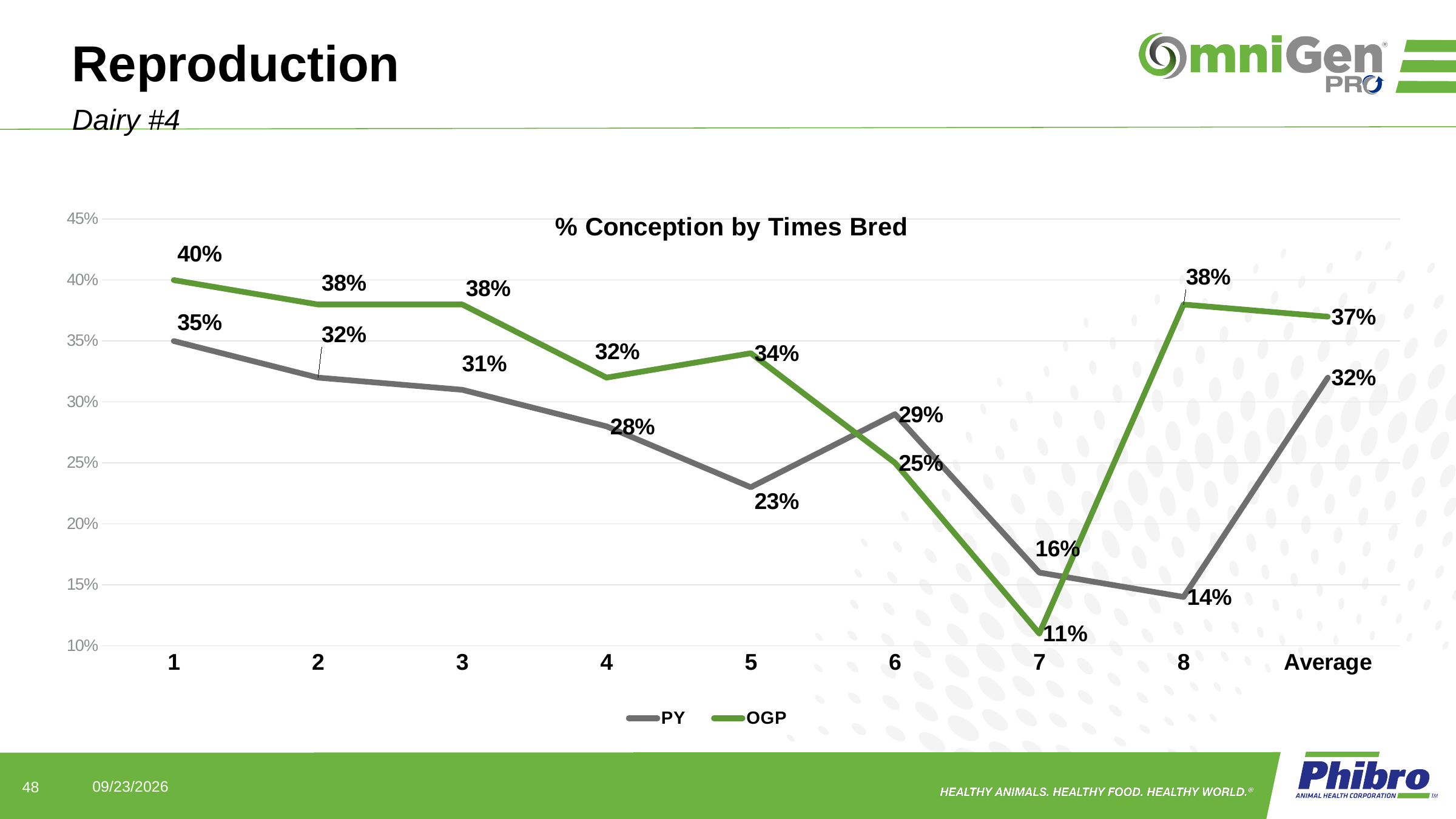
What is the OGP value at times bred 1? 40% What is the OGP value for Average? 37% What kind of chart is shown on the slide? Line chart How many categories are shown on the x axis? 9 What is the PY value at times bred 5? 23% What is the PY value at times bred 8? 14% At which times bred is the OGP value lowest? 7 What is the difference between the OGP and PY values at times bred 8? 24% What is the title of the chart? % Conception by Times Bred At which times bred is the OGP value highest? 1 How many series does the legend list? 2 Which series has the larger value at times bred 6, PY or OGP? PY